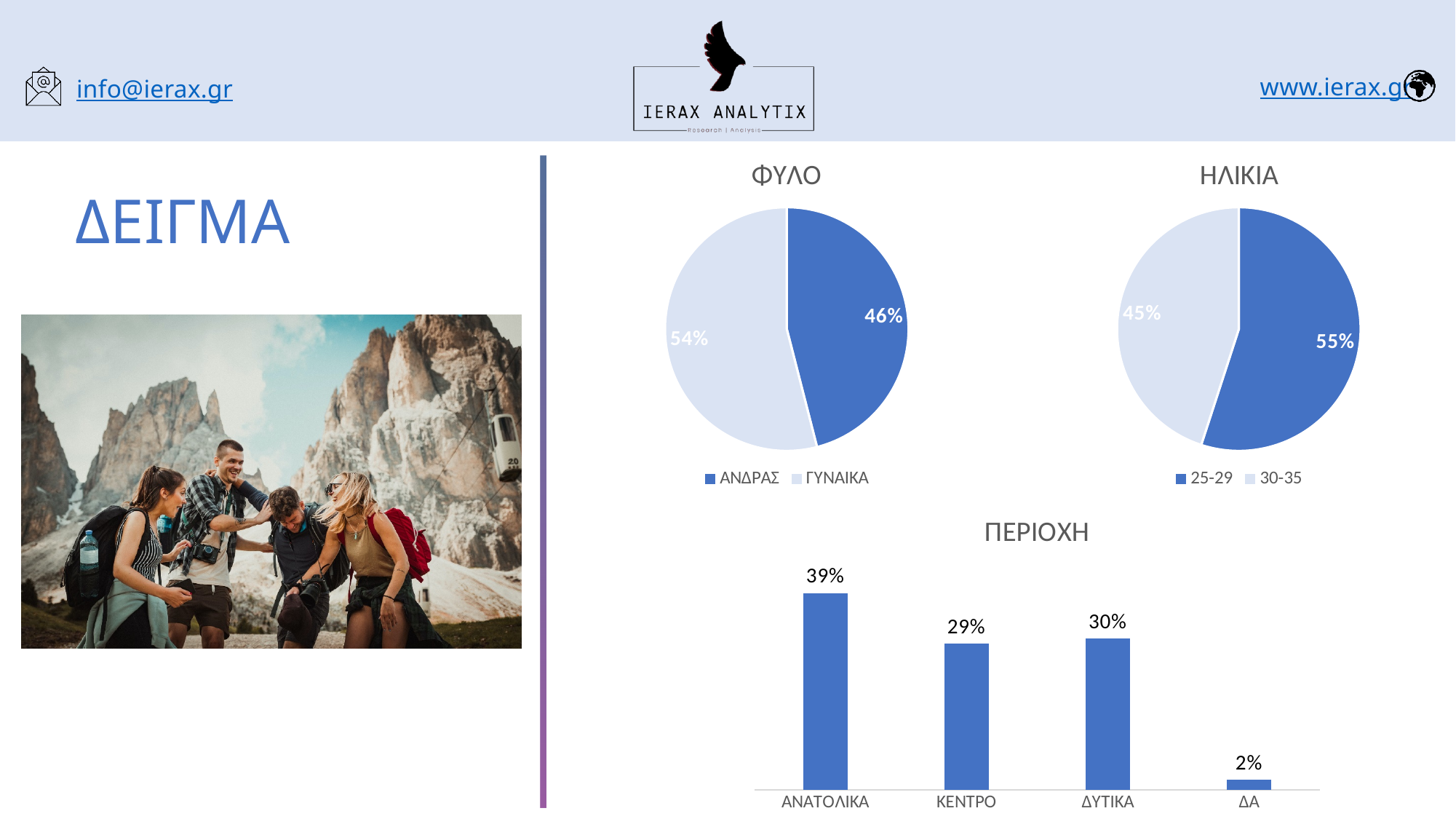
In the ΗΛΙΚΙΑ chart, what is the difference between the 25-29 and 30-35 shares? 10% How many categories does the ΠΕΡΙΟΧΗ chart show? 4 In the ΦΥΛΟ chart, what share is ΑΝΔΡΑΣ? 46% In the ΗΛΙΚΙΑ chart, what share is the 30-35 group? 45% In the ΠΕΡΙΟΧΗ chart, which category has the lowest value? ΔΑ What kind of chart is the ΗΛΙΚΙΑ chart? Pie chart In the ΠΕΡΙΟΧΗ chart, what is the value for ΑΝΑΤΟΛΙΚΑ? 39% In the ΠΕΡΙΟΧΗ chart, what is the difference between ΔΥΤΙΚΑ and ΚΕΝΤΡΟ? 1% In the ΠΕΡΙΟΧΗ chart, which category has the highest value? ΑΝΑΤΟΛΙΚΑ In the ΗΛΙΚΙΑ chart, what share is the 25-29 group? 55% In the ΦΥΛΟ chart, which slice is larger, ΑΝΔΡΑΣ or ΓΥΝΑΙΚΑ? ΓΥΝΑΙΚΑ